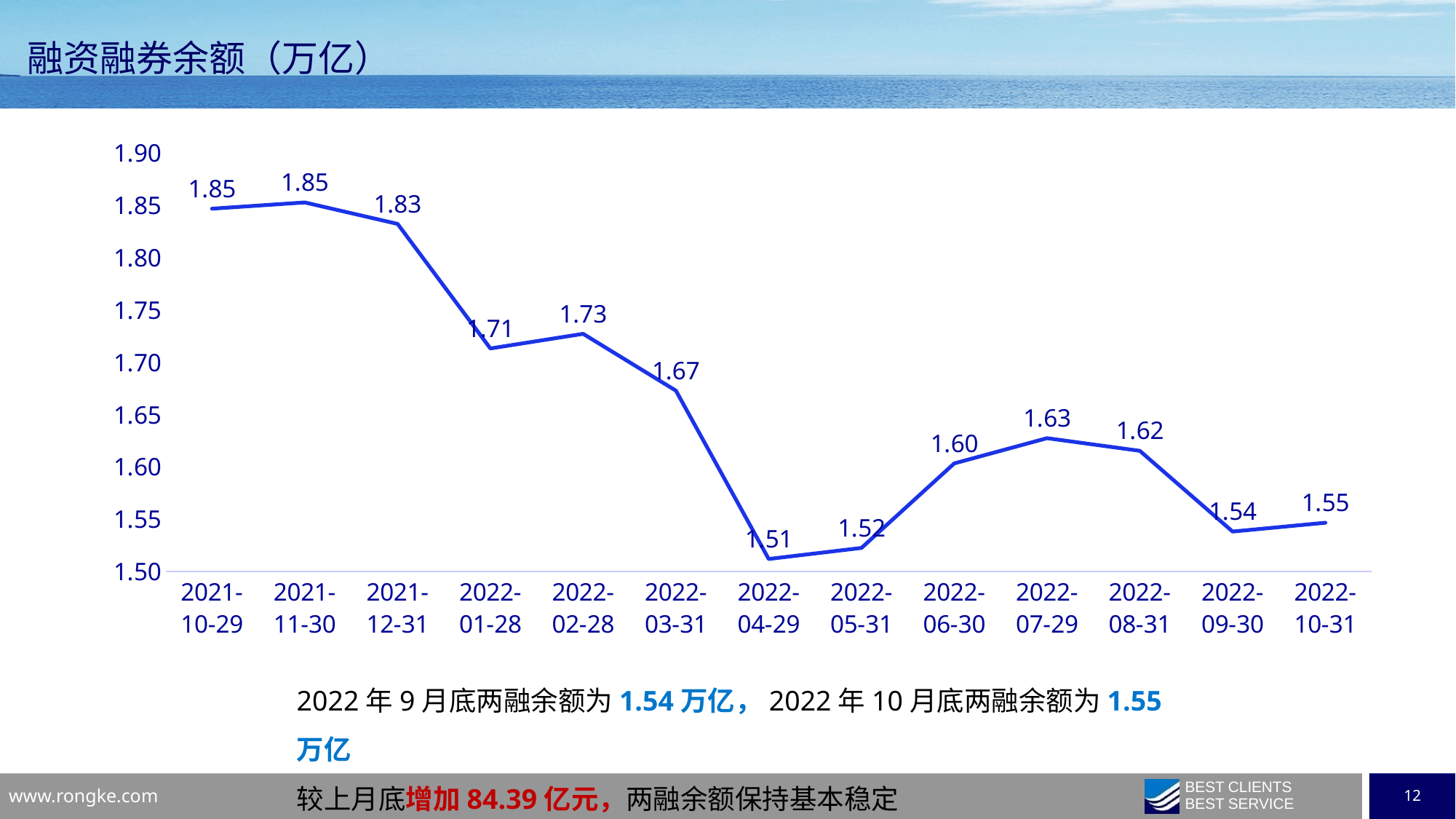
What is the value for 2022-07-29? 1.63 Do the values rise or fall from 2021-11-30 to 2022-04-29? fall Is the value for 2022-01-28 greater or less than 1.70? greater What is the difference between the values for 2022-03-31 and 2022-04-29? 0.16 What is the value for 2022-04-29? 1.51 What kind of chart is shown on the slide? line chart Which is larger, the value for 2022-02-28 or the value for 2022-06-30? 2022-02-28 What is the difference between the values for 2021-10-29 and 2022-10-31? 0.30 What is the value for 2021-12-31? 1.83 How many data points are plotted on the chart? 13 Which date has the lowest value? 2022-04-29 What is the title of the chart? 融资融券余额（万亿）